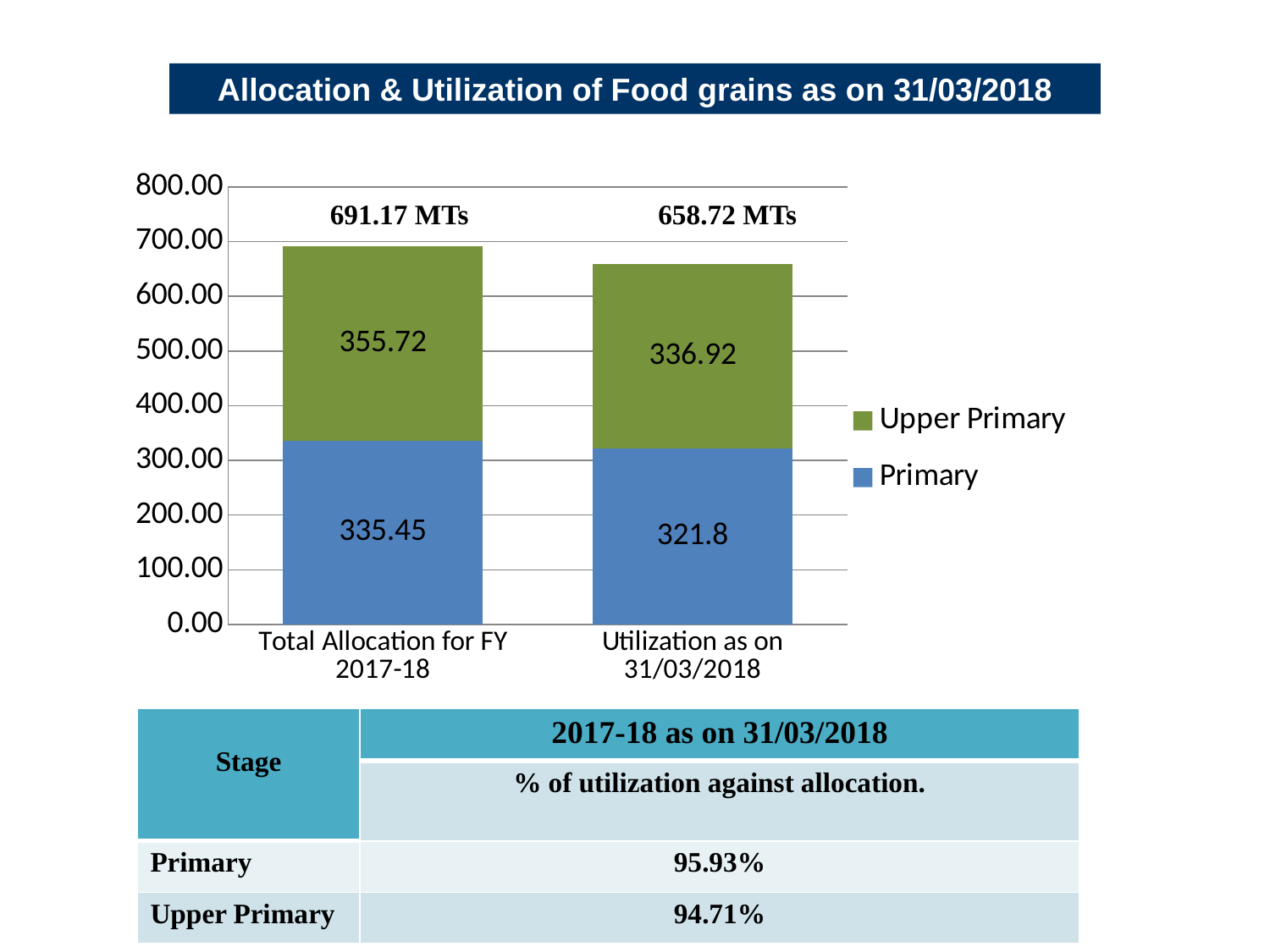
What is the difference between the Upper Primary values for Total Allocation for FY 2017-18 and Utilization as on 31/03/2018? 18.8 What type of chart is shown on the slide? Stacked bar chart What is the Upper Primary value for Utilization as on 31/03/2018? 336.92 Which colour represents Upper Primary in the chart? Green What is the Primary value for Utilization as on 31/03/2018? 321.8 In the Total Allocation for FY 2017-18 bar, which is larger, Primary or Upper Primary? Upper Primary What is the total of the Total Allocation for FY 2017-18 bar? 691.17 MTs What is the difference between the Primary values for Total Allocation for FY 2017-18 and Utilization as on 31/03/2018? 13.65 What is the Upper Primary value for Total Allocation for FY 2017-18? 355.72 What is the Primary value for Total Allocation for FY 2017-18? 335.45 How many series does the legend list? 2 What is the total of the Utilization as on 31/03/2018 bar? 658.72 MTs